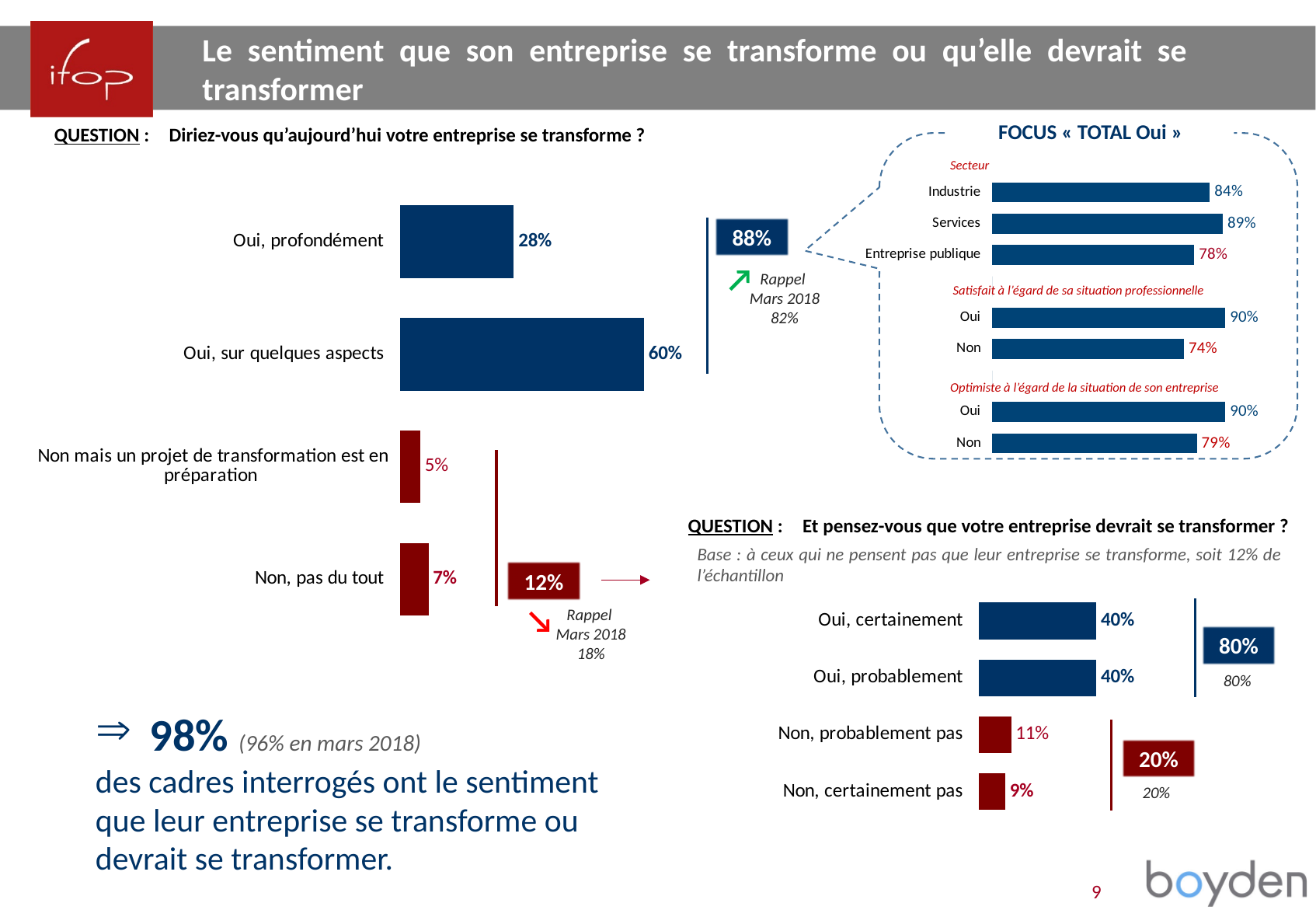
In the FOCUS « TOTAL Oui » chart, which is larger: "Industrie" or "Entreprise publique"? Industrie In the FOCUS « TOTAL Oui » chart, what is the value for "Services"? 89% In the chart for the question "Diriez-vous qu'aujourd'hui votre entreprise se transforme ?", what is the combined total shown for the two "Non" answers? 12% In the chart for the question "Et pensez-vous que votre entreprise devrait se transformer ?", what is the value for "Non, probablement pas"? 11% In the FOCUS « TOTAL Oui » chart, what is the difference between "Oui" and "Non" under "Satisfait à l'égard de sa situation professionnelle"? 16 percentage points In the chart for the question "Diriez-vous qu'aujourd'hui votre entreprise se transforme ?", which category has the lowest value? Non mais un projet de transformation est en préparation In the chart for the question "Et pensez-vous que votre entreprise devrait se transformer ?", what is the combined total shown for the two "Oui" answers? 80% In the chart for the question "Diriez-vous qu'aujourd'hui votre entreprise se transforme ?", what is the value for "Oui, sur quelques aspects"? 60% In the chart for the question "Diriez-vous qu'aujourd'hui votre entreprise se transforme ?", how many categories are shown? 4 In the FOCUS « TOTAL Oui » chart, which sector has the lowest value? Entreprise publique What kind of chart is used for the question "Et pensez-vous que votre entreprise devrait se transformer ?"? Bar chart In the chart for the question "Diriez-vous qu'aujourd'hui votre entreprise se transforme ?", what is the difference between "Oui, sur quelques aspects" and "Oui, profondément"? 32 percentage points